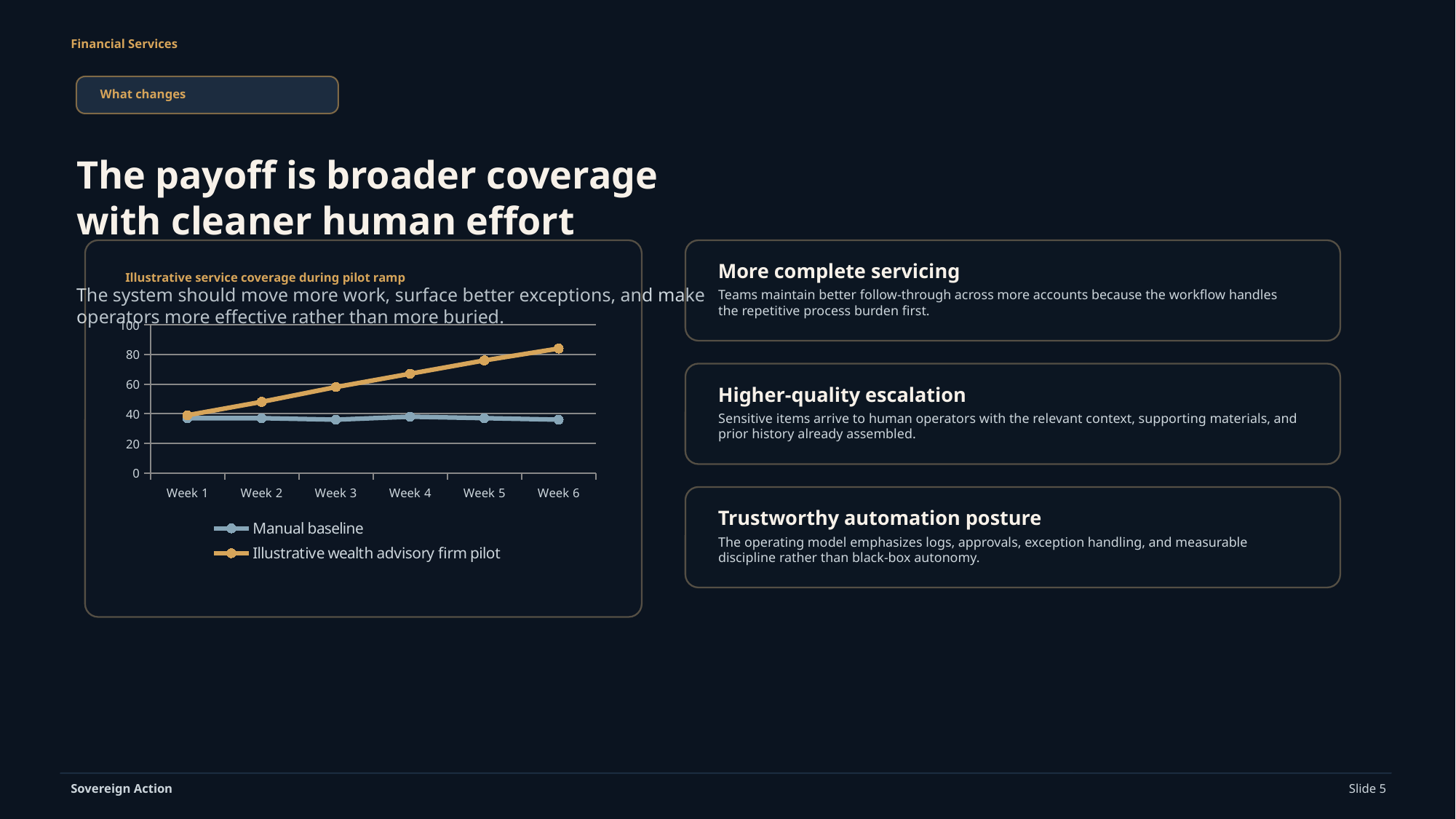
In Week 6, which series has the larger value, Manual baseline or Illustrative wealth advisory firm pilot? Illustrative wealth advisory firm pilot How many series does the chart legend list? 2 In which week is the Illustrative wealth advisory firm pilot value highest? Week 6 Is the value for Illustrative wealth advisory firm pilot in Week 4 greater or less than 60? greater In which week is the Illustrative wealth advisory firm pilot value lowest? Week 1 Is the value for Illustrative wealth advisory firm pilot in Week 6 greater or less than 80? greater Is the value for Manual baseline in Week 6 greater or less than 40? less Does the Illustrative wealth advisory firm pilot series rise or fall from Week 1 to Week 6? Rise What is the title of the chart? Illustrative service coverage during pilot ramp What kind of chart is shown on the slide? Line chart Which series is drawn in orange in the chart? Illustrative wealth advisory firm pilot How many weeks are plotted along the x axis of the chart? 6